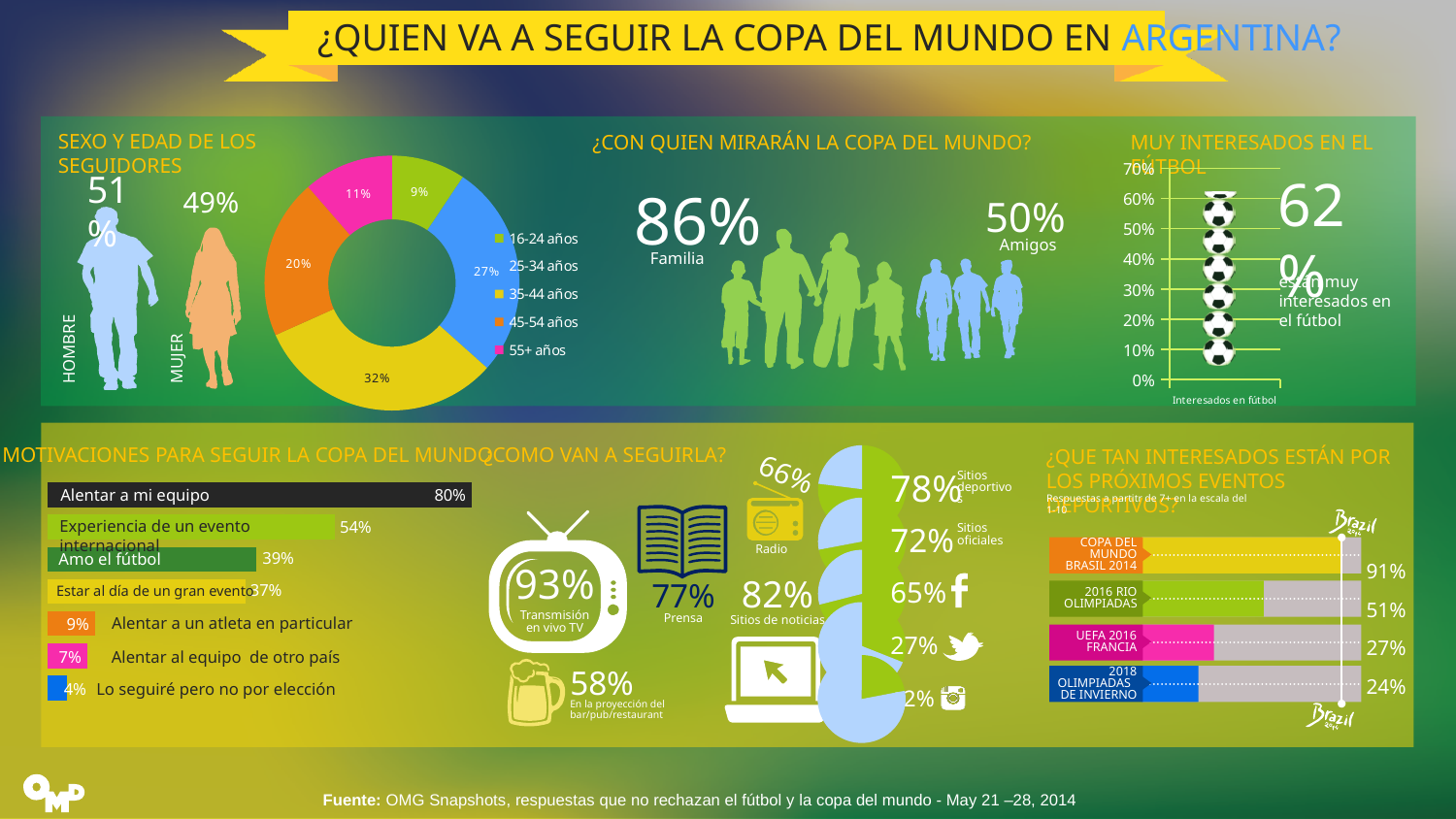
What is the largest percentage shown on the 'SEXO Y EDAD DE LOS SEGUIDORES' donut chart? 32% In the '¿QUE TAN INTERESADOS ESTÁN POR LOS PRÓXIMOS EVENTOS DEPORTIVOS?' bar chart, which event has the highest value? COPA DEL MUNDO BRASIL 2014 In the '¿QUE TAN INTERESADOS ESTÁN POR LOS PRÓXIMOS EVENTOS DEPORTIVOS?' bar chart, which is larger: 'UEFA 2016 FRANCIA' or '2018 OLIMPIADAS DE INVIERNO'? UEFA 2016 FRANCIA In the 'MUY INTERESADOS EN EL FÚTBOL' chart, what is the value of the 'Interesados en fútbol' bar? 62% In the 'MOTIVACIONES PARA SEGUIR LA COPA DEL MUNDO' bar chart, what is the value for 'Alentar a mi equipo'? 80% In the '¿QUE TAN INTERESADOS ESTÁN POR LOS PRÓXIMOS EVENTOS DEPORTIVOS?' bar chart, what is the value for '2016 RIO OLIMPIADAS'? 51% In the 'MOTIVACIONES PARA SEGUIR LA COPA DEL MUNDO' bar chart, what is the difference between 'Alentar a mi equipo' and 'Amo el fútbol'? 41% In the 'MOTIVACIONES PARA SEGUIR LA COPA DEL MUNDO' bar chart, which motivation has the lowest value? Lo seguiré pero no por elección What kind of chart is used for 'SEXO Y EDAD DE LOS SEGUIDORES'? Donut (pie) chart How many events are shown in the '¿QUE TAN INTERESADOS ESTÁN POR LOS PRÓXIMOS EVENTOS DEPORTIVOS?' bar chart? 4 How many motivations are listed in the 'MOTIVACIONES PARA SEGUIR LA COPA DEL MUNDO' bar chart? 7 How many age groups does the legend of the 'SEXO Y EDAD DE LOS SEGUIDORES' donut chart list? 5